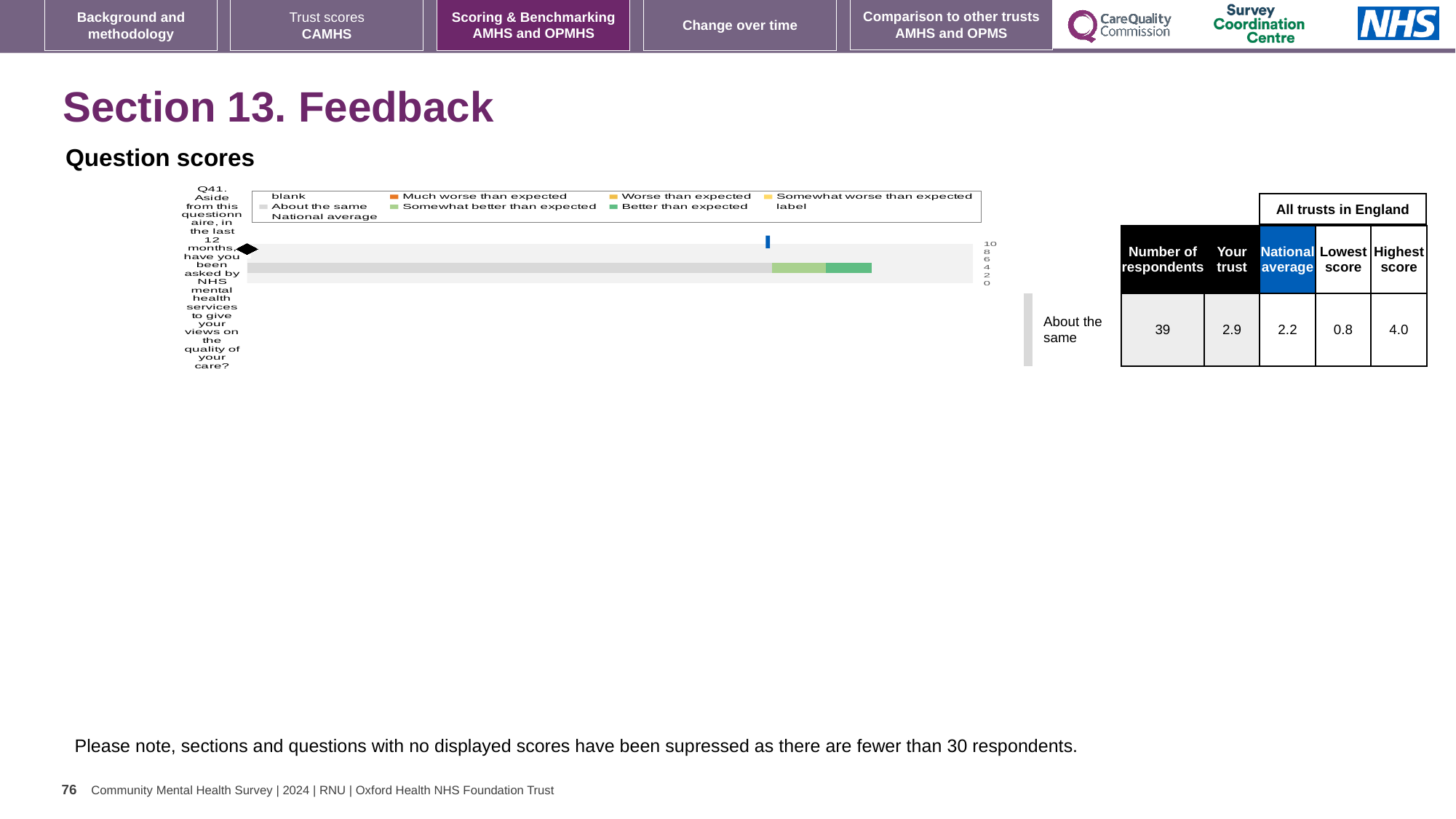
What kind of chart is shown for Q41 on the slide? bar chart What is the national average score shown for Q41? 2.2 What is the highest score among all trusts in England for Q41? 4.0 How many questions (categories) are plotted in the Q41 chart? 1 How many respondents are shown for Q41? 39 Which is larger for Q41, the 'Your trust' score or the national average? Your trust What colour represents 'Better than expected' in the chart legend? green What is the lowest score among all trusts in England for Q41? 0.8 What is the 'Your trust' score shown for Q41? 2.9 What is the difference between the highest and lowest scores for Q41 across all trusts in England? 3.2 What benchmark category is shown next to the Q41 chart? About the same What is the difference between the 'Your trust' score and the national average for Q41? 0.7